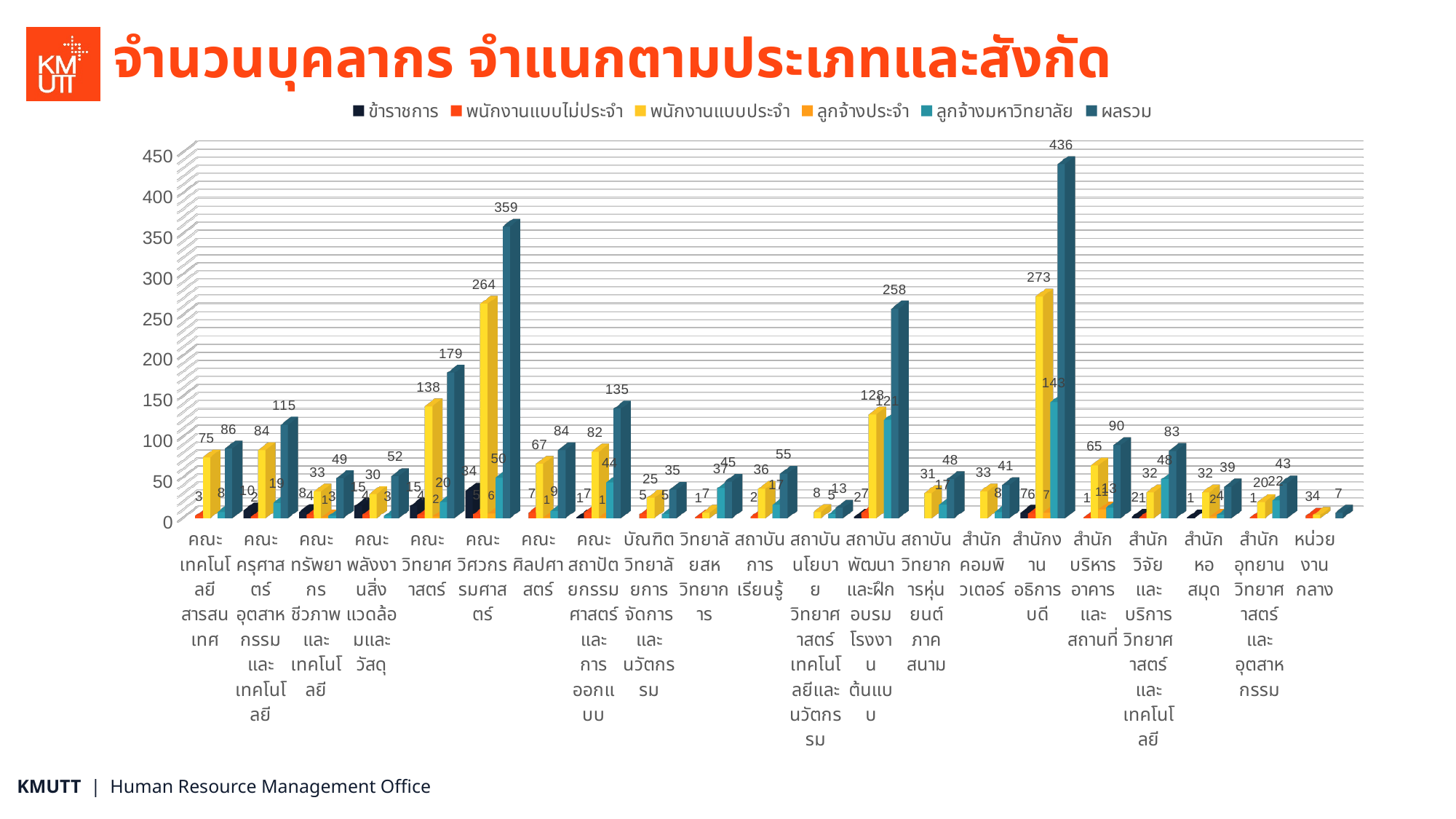
What is the ผลรวม value for คณะวิศวกรรมศาสตร์? 359 Which has the larger ผลรวม value: คณะครุศาสตร์อุตสาหกรรมและเทคโนโลยี or คณะสถาปัตยกรรมศาสตร์และการออกแบบ? คณะสถาปัตยกรรมศาสตร์และการออกแบบ Which unit has the lowest ผลรวม value? หน่วยงานกลาง What is the ลูกจ้างมหาวิทยาลัย value for สถาบันพัฒนาและฝึกอบรมโรงงานต้นแบบ? 121 How many categories (units) are shown along the x axis? 21 What is the difference between the ผลรวม values of สำนักงานอธิการบดี and คณะวิศวกรรมศาสตร์? 77 How many series does the legend list? 6 What is the พนักงานแบบประจำ value for คณะวิทยาศาสตร์? 138 What kind of chart is shown on the slide? Bar chart What is the ผลรวม value for สำนักหอสมุด? 39 Which unit has the highest ผลรวม value? สำนักงานอธิการบดี What is the title of the chart? จำนวนบุคลากร จำแนกตามประเภทและสังกัด